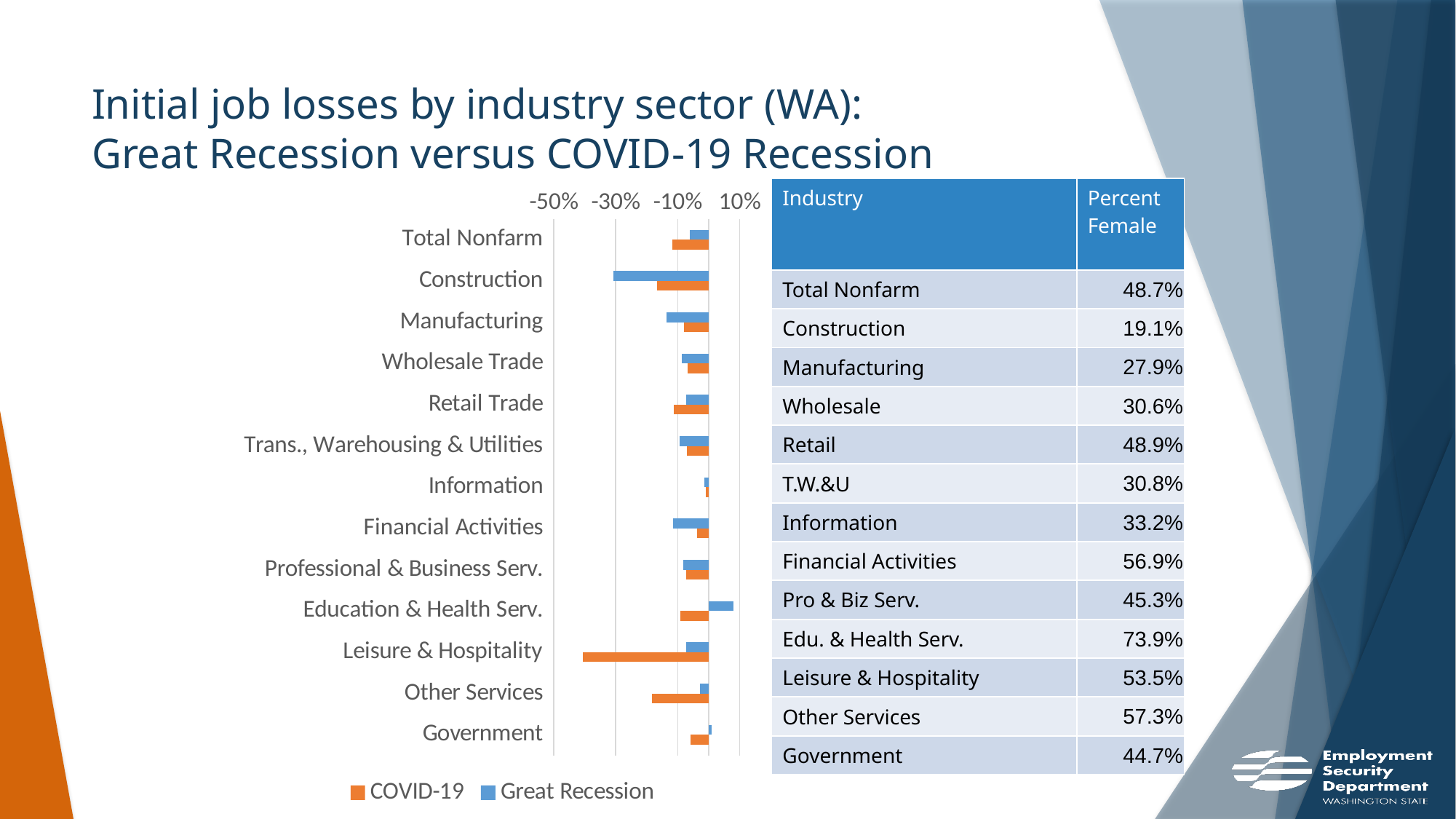
How many series does the chart's legend list? 2 How many industry categories are plotted in the chart? 13 Which colour represents the COVID-19 series in the chart? orange What kind of chart is shown on the slide? bar chart Which industry has the smallest COVID-19 bar in the chart? Information Is the Great Recession value for Education & Health Serv. greater or less than -10%? greater Is the COVID-19 value for Leisure & Hospitality greater or less than -30%? less For Construction, which series shows the larger job loss, COVID-19 or Great Recession? Great Recession Which industry has the largest COVID-19 job loss (longest COVID-19 bar) in the chart? Leisure & Hospitality Which industry has the largest Great Recession job loss (longest Great Recession bar) in the chart? Construction Is the COVID-19 value for Other Services greater or less than -10%? less For Leisure & Hospitality, which series shows the larger job loss, COVID-19 or Great Recession? COVID-19